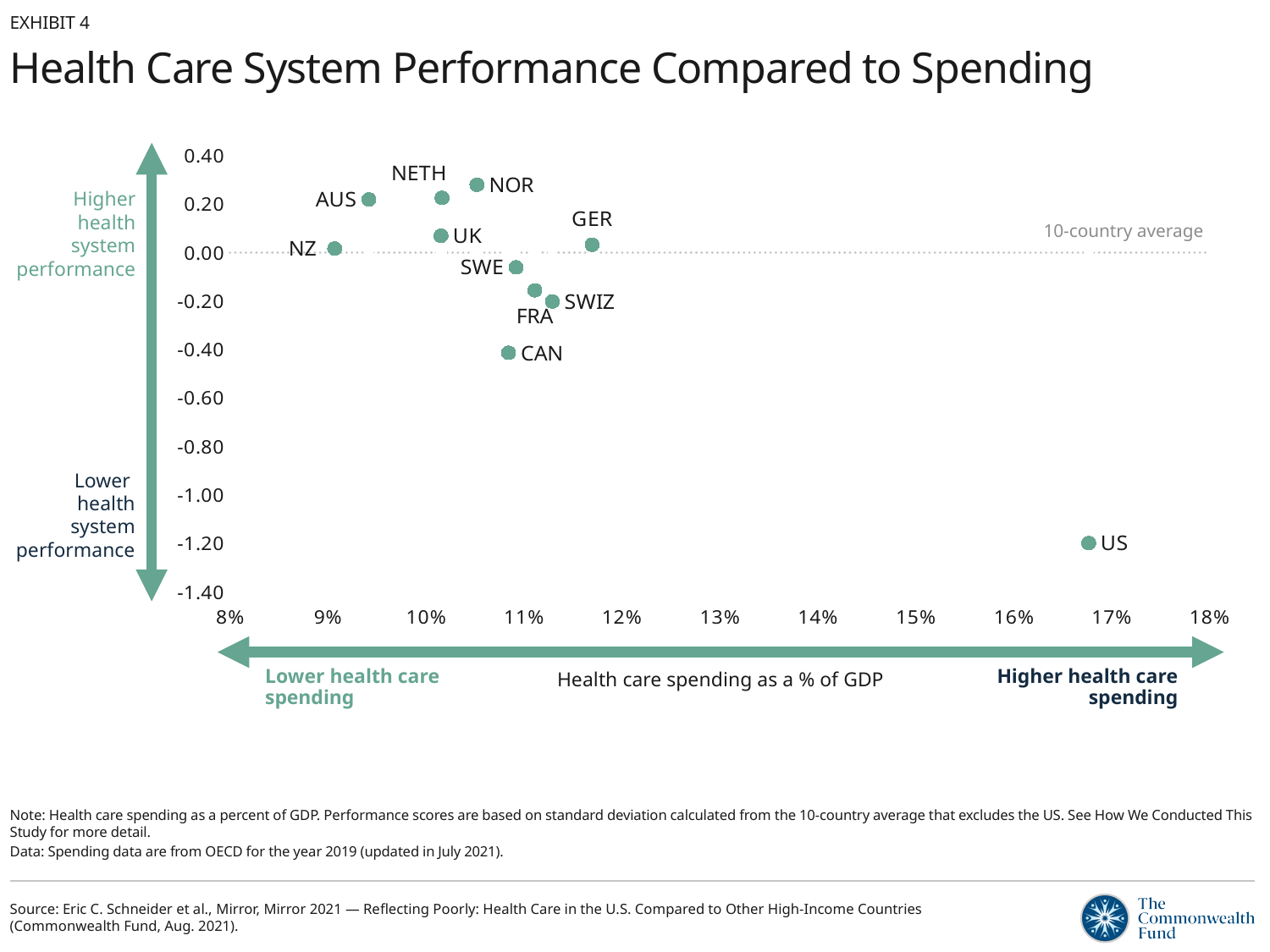
Is the health care spending as a % of GDP for AUS greater or less than 10%? less Which has higher health care spending as a % of GDP, GER or US? US Which has a higher health system performance score, SWE or CAN? SWE Is the health system performance score for the US greater or less than -1.00? less Which country has the lowest health system performance score? US What is the label of the horizontal axis? Health care spending as a % of GDP How many countries are plotted on the chart? 11 What kind of chart is shown on the slide? Scatter chart Is the health system performance score for CAN greater or less than -0.20? less Which country has the lowest health care spending as a % of GDP? NZ Which country has the highest health care spending as a % of GDP? US